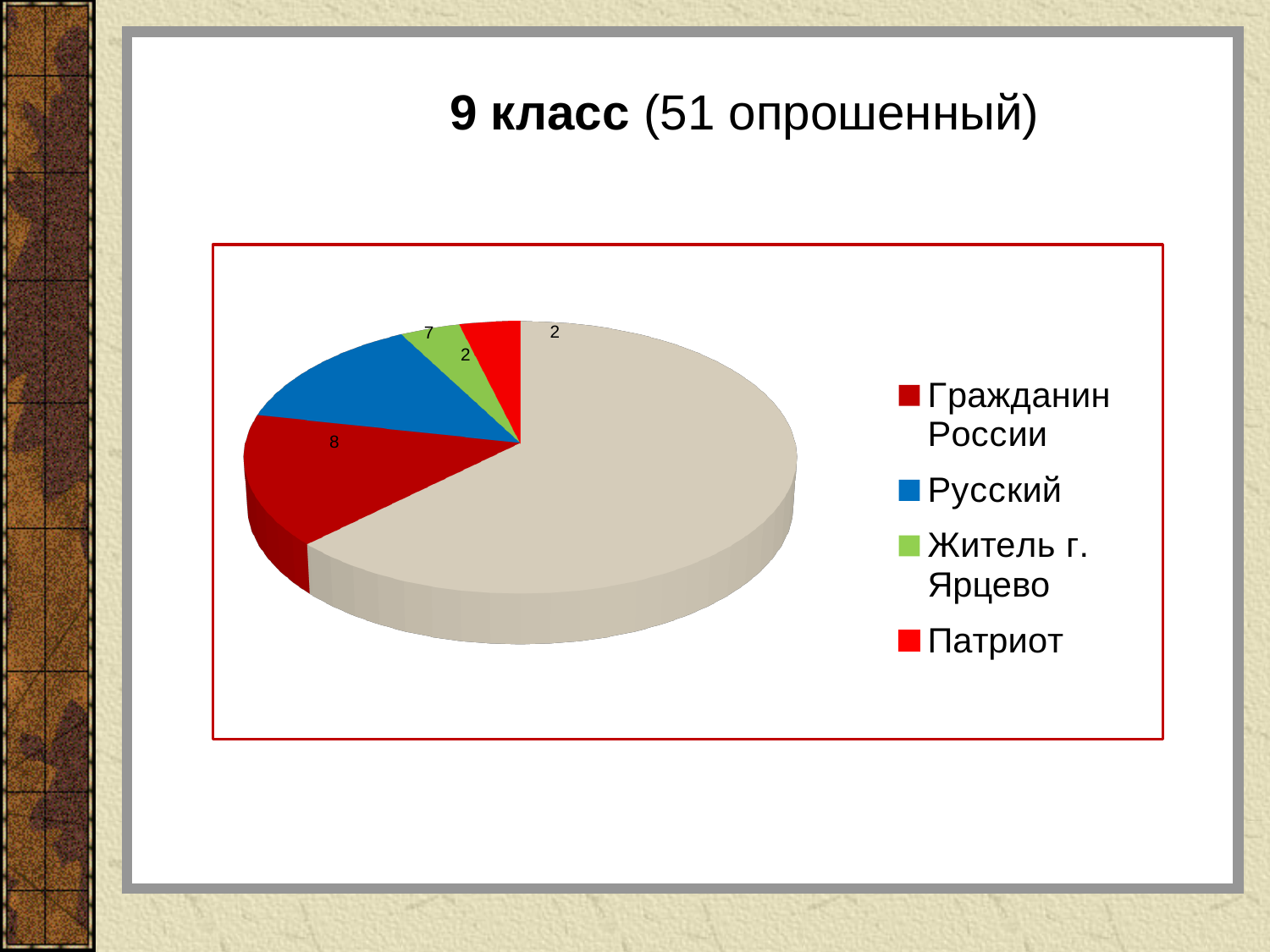
What kind of chart is shown on the slide? Pie chart What value is shown for the Патриот slice? 2 Which of the categories listed in the legend has the largest value? Гражданин России Which is larger, the value for Русский or the value for Патриот? Русский Which is larger, the value for Гражданин России or the value for Русский? Гражданин России What is the difference between the values for Русский and Житель г. Ярцево? 5 What value is shown for the Гражданин России slice? 8 How many entries does the legend list? 4 What value is shown for the Русский slice? 7 What value is shown for the Житель г. Ярцево slice? 2 What is the title of the slide above the chart? 9 класс (51 опрошенный) What is the difference between the values for Гражданин России and Русский? 1